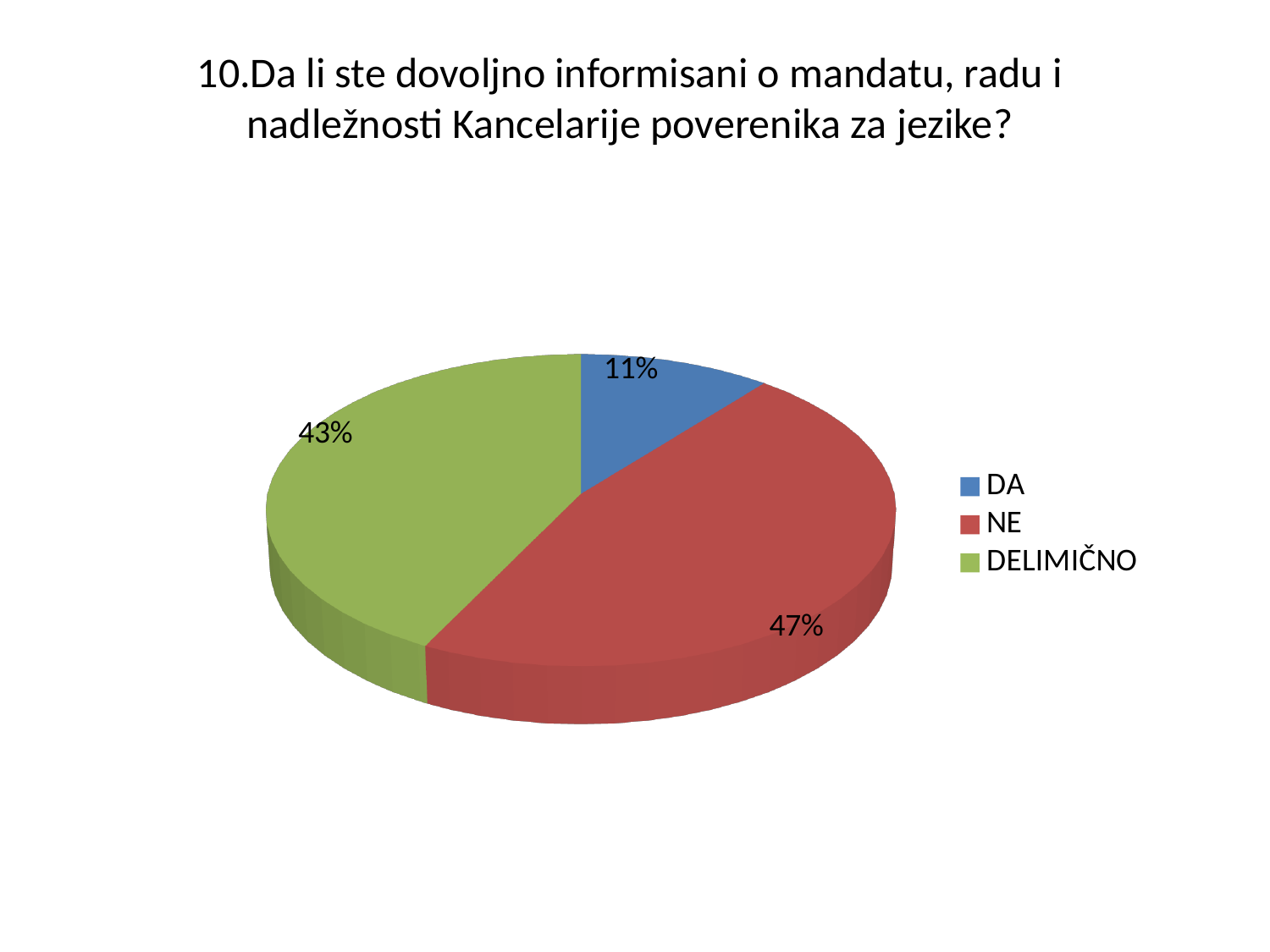
What kind of chart is shown on the slide? pie chart What is the difference in percentage points between DELIMIČNO and DA? 32 What percentage of respondents answered NE? 47% Which response has the largest share of the pie? NE What colour is the slice for NE? red What percentage of respondents answered DELIMIČNO? 43% What percentage of respondents answered DA? 11% Which legend entry is shown in green? DELIMIČNO How many categories does the pie chart show? 3 Which is larger, the share for DA or the share for DELIMIČNO? DELIMIČNO Which response has the smallest share of the pie? DA What is the difference in percentage points between NE and DELIMIČNO? 4